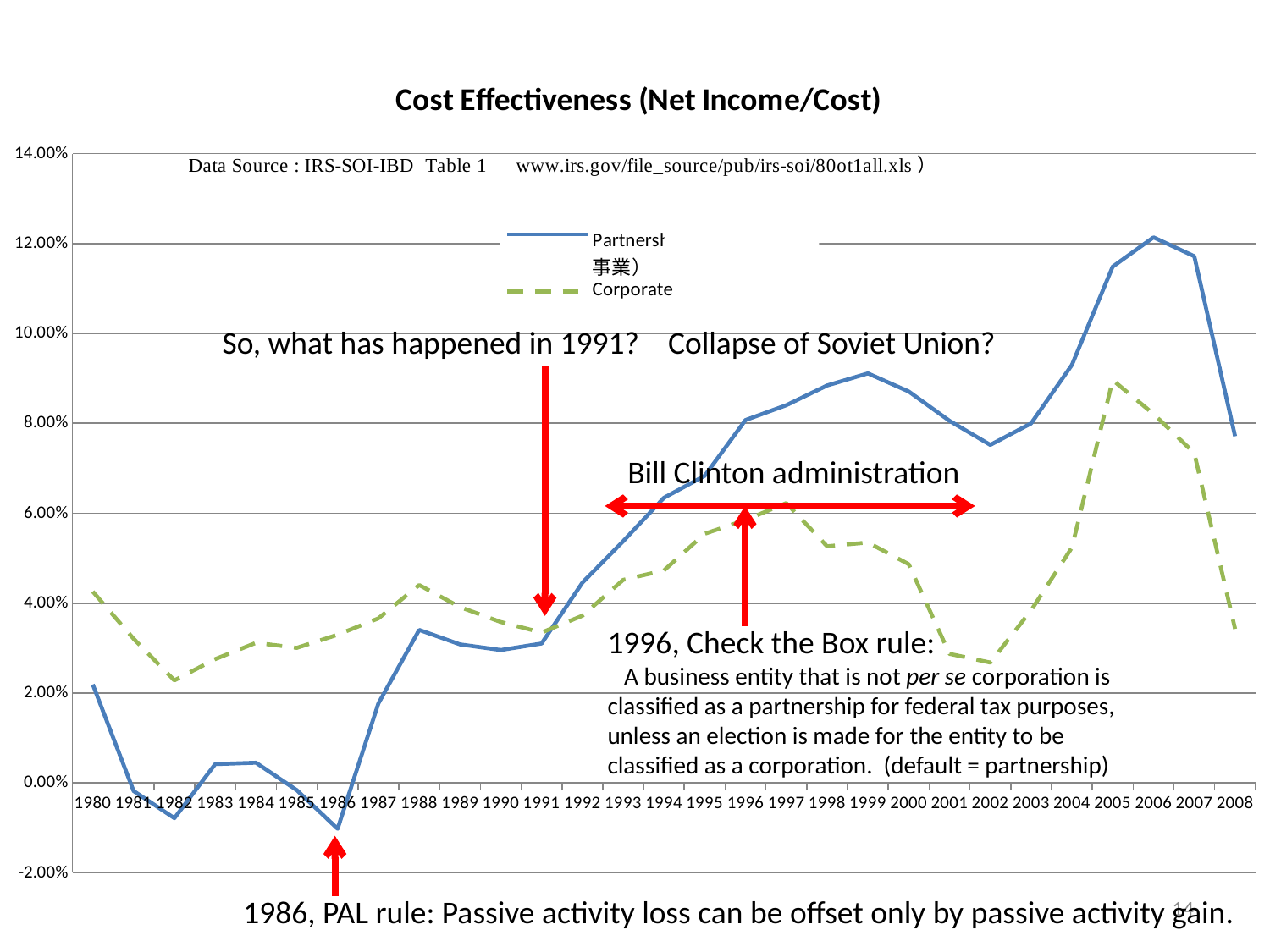
In which year does the Partnership series reach its lowest value? 1986 How many series does the chart's legend list? 2 Does the Partnership series rise or fall from 2006 to 2008? fall Is the Partnership value for 2006 greater or less than 10.00%? greater In 1980, which series has the larger value, Partnership or Corporate? Corporate In which year does the Partnership series reach its highest value? 2006 In which year does the Corporate series reach its highest value? 2005 What kind of chart is shown on the slide? line chart Is the Corporate value for 2005 greater or less than 8.00%? greater In 2006, which series has the larger value, Partnership or Corporate? Partnership How many years are plotted along the x axis of the chart? 29 Is the Partnership value for 1986 greater or less than 0.00%? less